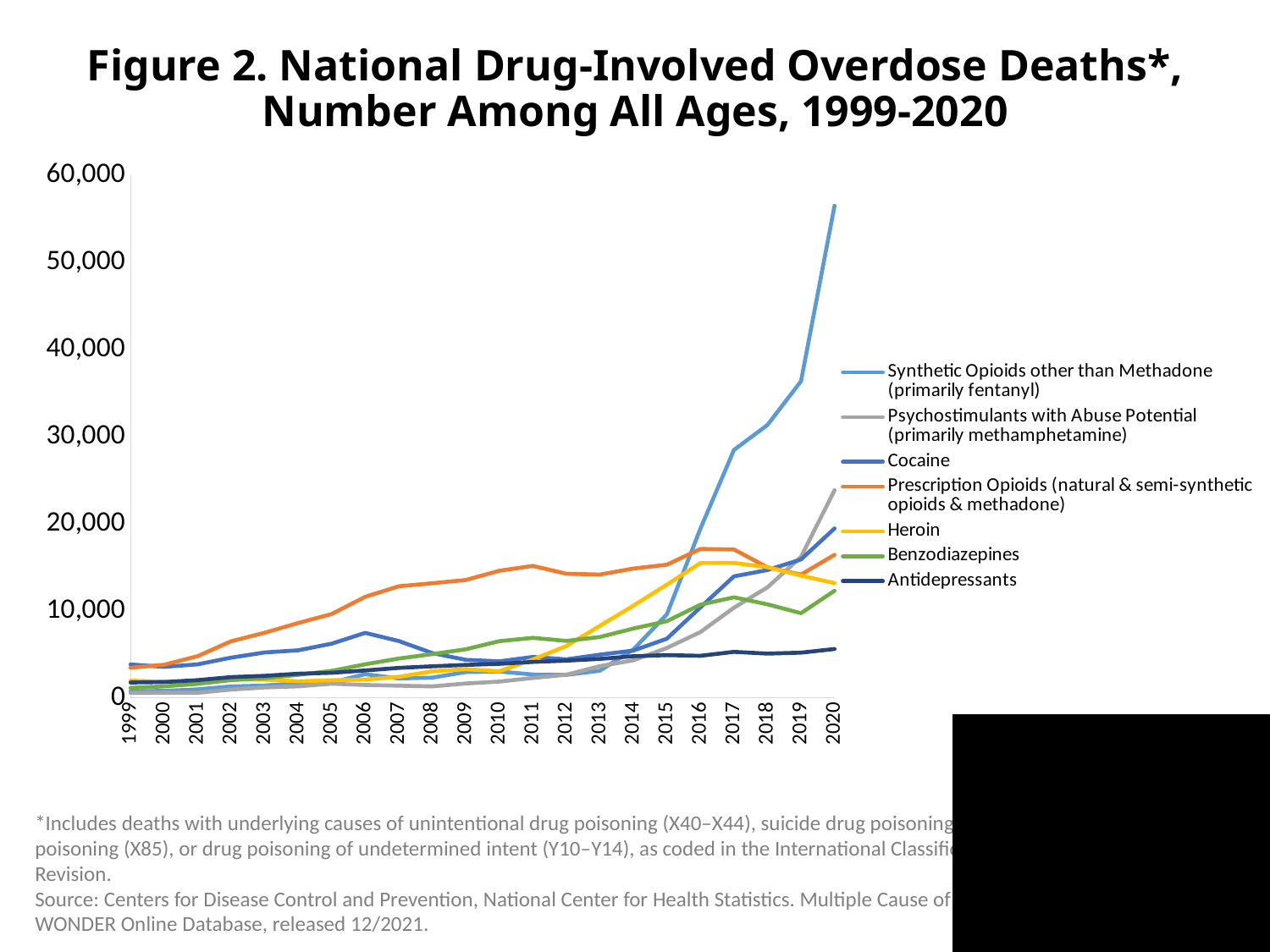
Is the value for Antidepressants in 2020 greater or less than 10,000? less Is the value for Psychostimulants with Abuse Potential in 2020 greater or less than 20,000? greater What kind of chart is shown on the slide? Line chart How many series does the legend list? 7 Which series has the lowest value in 2020? Antidepressants What is the title of the chart? Figure 2. National Drug-Involved Overdose Deaths*, Number Among All Ages, 1999-2020 Which series has the highest value in 2020? Synthetic Opioids other than Methadone (primarily fentanyl) Is the value for Synthetic Opioids other than Methadone in 2020 greater or less than 50,000? greater How many years are shown along the x axis? 22 In 2020, which is larger: Synthetic Opioids other than Methadone or Cocaine? Synthetic Opioids other than Methadone Does the Synthetic Opioids other than Methadone series rise or fall from 2013 to 2020? Rise